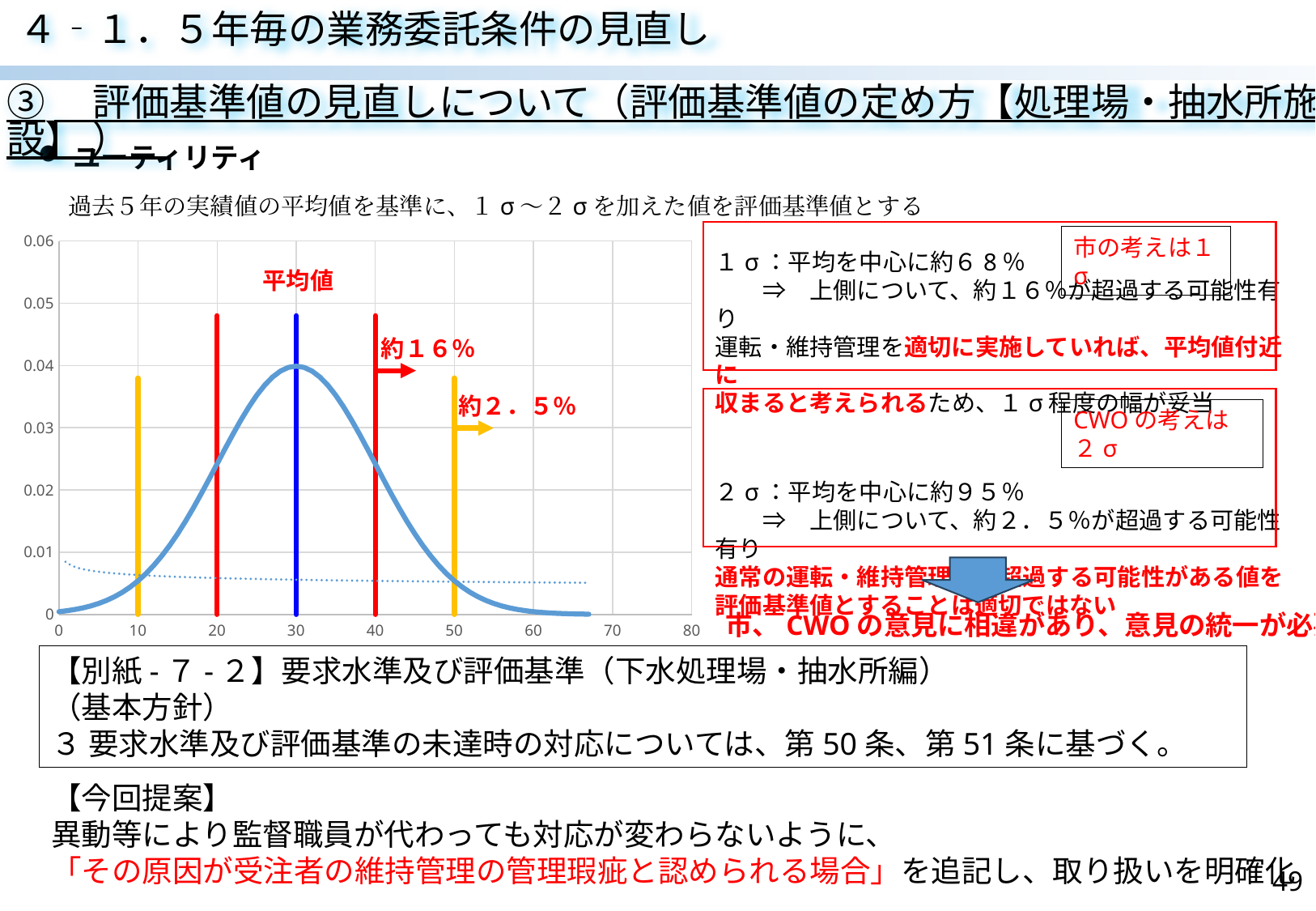
At which two x-axis values are the red vertical lines drawn? 20 and 40 What is the maximum value shown on the y axis of the chart? 0.06 At which x-axis value does the bell curve reach its highest point? 30 At which x-axis value is the blue vertical line labelled 平均値 located? 30 What percentage label is shown next to the yellow vertical line at x = 50? 約2.5% What kind of chart is shown on the left of the slide? line chart Is the value of the bell curve at x = 50 greater or less than 0.01? less At which two x-axis values are the yellow vertical lines drawn? 10 and 50 Is the peak of the bell curve greater or less than 0.03? greater How does the bell curve behave as x increases from 30 to 60? it falls What percentage label is shown next to the red vertical line at x = 40? 約16% Is the peak of the bell curve greater or less than 0.05? less